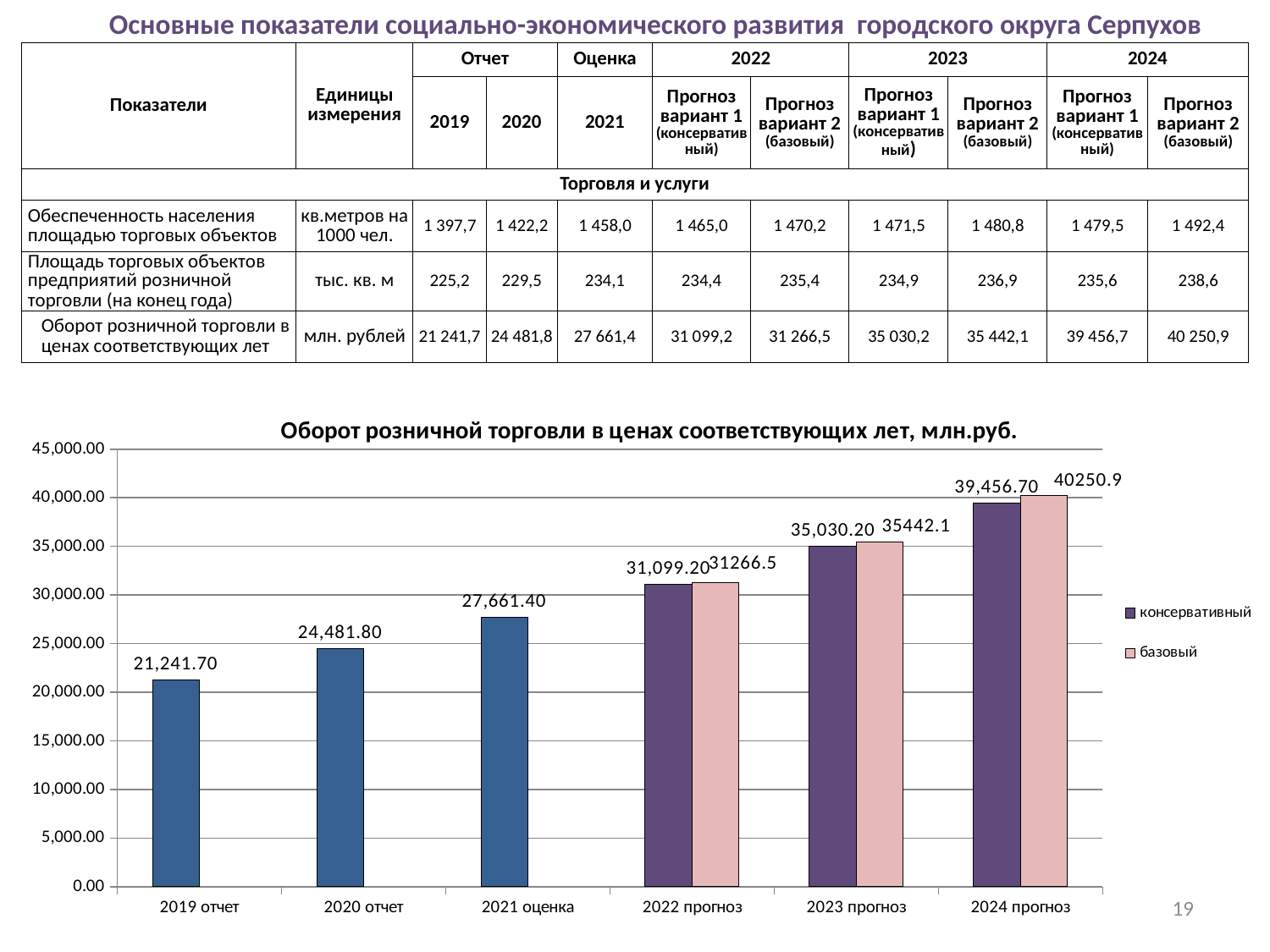
What is the value of the bar for 2019 отчет? 21,241.70 What is the value of the консервативный bar for 2023 прогноз? 35,030.20 Which category has the lowest bar in the chart? 2019 отчет What is the value of the базовый bar for 2022 прогноз? 31266.5 Do the values rise or fall from 2019 отчет to 2024 прогноз? rise What type of chart is shown on the slide? bar chart What is the value of the базовый bar for 2024 прогноз? 40250.9 What is the value of the bar for 2021 оценка? 27,661.40 Which is larger for 2023 прогноз: the консервативный bar or the базовый bar? базовый How many series does the legend list? 2 Which bar is the highest in the chart? базовый for 2024 прогноз What is the difference between the 2020 отчет bar and the 2019 отчет bar? 3,240.10